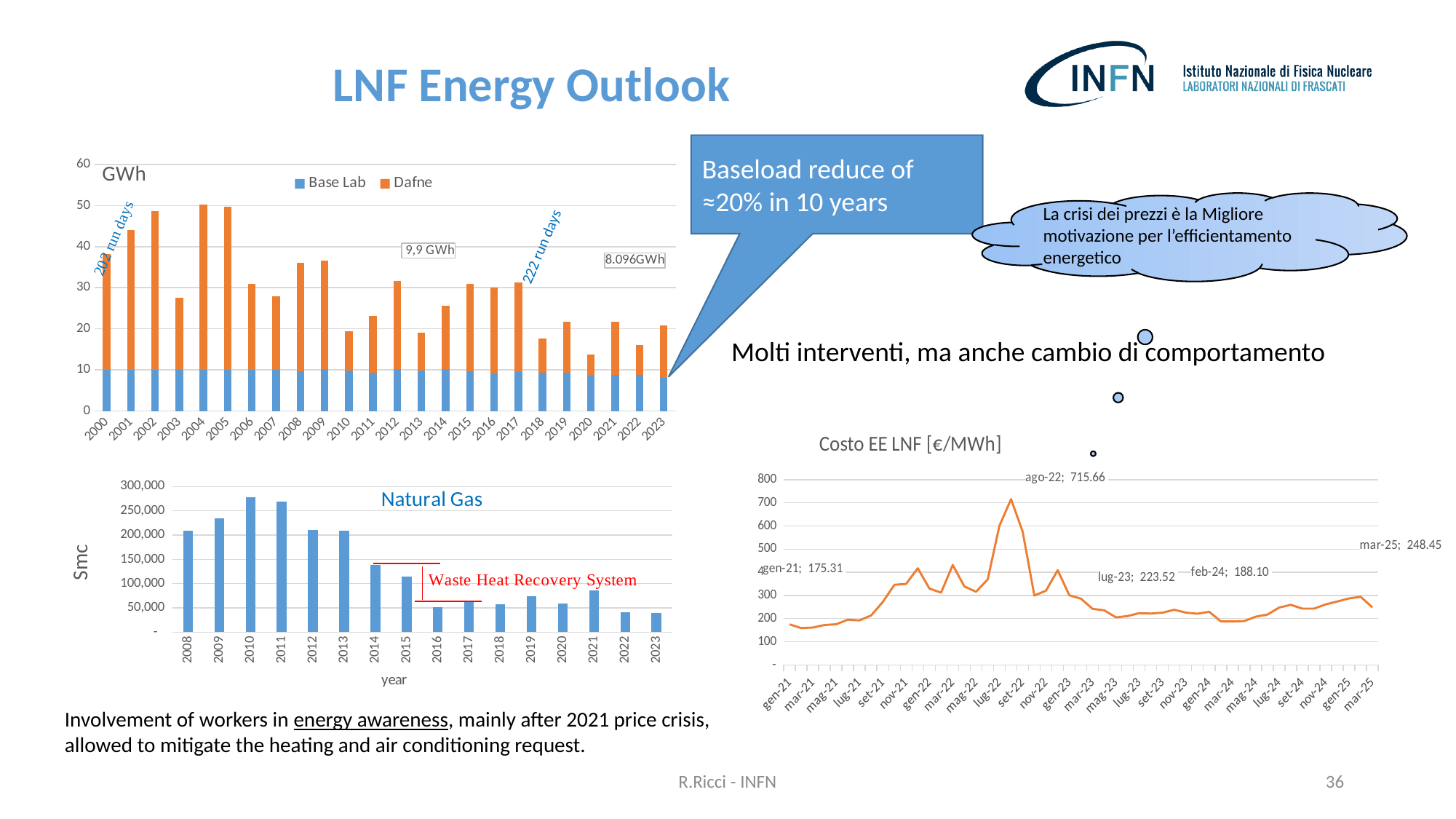
What kind of chart is the 'Costo EE LNF [€/MWh]' chart? line chart In the 'Costo EE LNF [€/MWh]' chart, what is the value labelled for ago-22? 715.66 In the 'Costo EE LNF [€/MWh]' chart, what is the difference between the ago-22 value and the gen-21 value? 540.35 How many series does the legend of the top-left GWh chart list? 2 In the 'Costo EE LNF [€/MWh]' chart, what is the value labelled for gen-21? 175.31 In the 'Natural Gas' chart, is the value for 2016 greater or less than 100,000? less In the 'Costo EE LNF [€/MWh]' chart, what is the value labelled for mar-25? 248.45 In the top-left GWh chart, is the total for 2002 greater or less than 40? greater In the 'Costo EE LNF [€/MWh]' chart, which is larger, the labelled value for lug-23 or for feb-24? lug-23 In the 'Costo EE LNF [€/MWh]' chart, which month has the highest value? ago-22 How many years are shown on the x axis of the 'Natural Gas' chart? 16 In the top-left GWh chart, which year has the lowest total? 2020